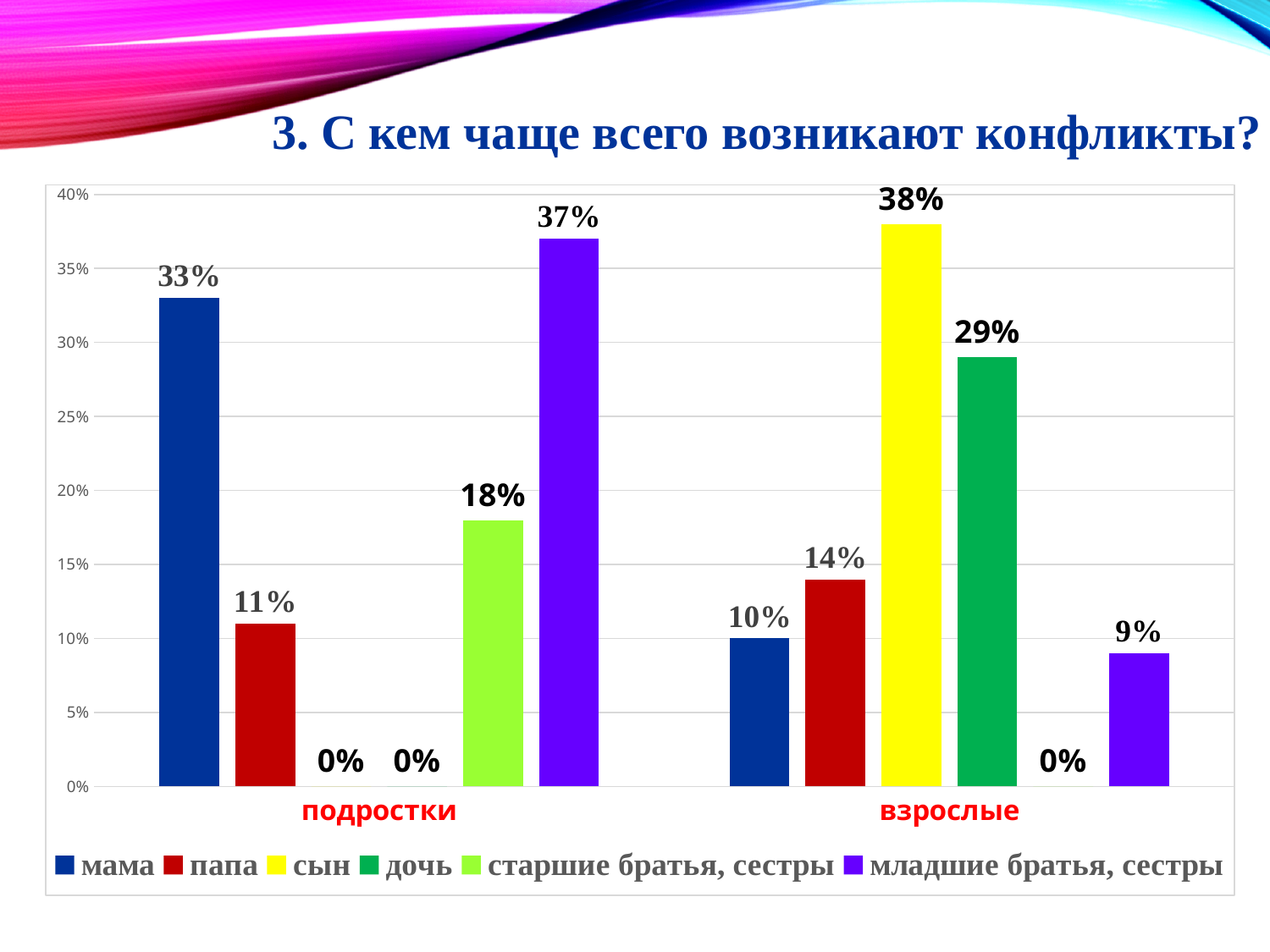
What is the title of the slide? 3. С кем чаще всего возникают конфликты? What is the value for "дочь" in the "взрослые" group? 29% What kind of chart is shown on the slide? bar chart How many series does the legend list? 6 What is the difference between "младшие братья, сестры" for "подростки" and for "взрослые"? 28% What is the value for "сын" in the "взрослые" group? 38% How many category groups are shown on the x axis? 2 What is the value for "мама" in the "подростки" group? 33% Which is larger: "папа" for "подростки" or "папа" for "взрослые"? папа for взрослые What is the value for "старшие братья, сестры" in the "подростки" group? 18% Which series has the highest value in the "взрослые" group? сын Which series has the highest value in the "подростки" group? младшие братья, сестры